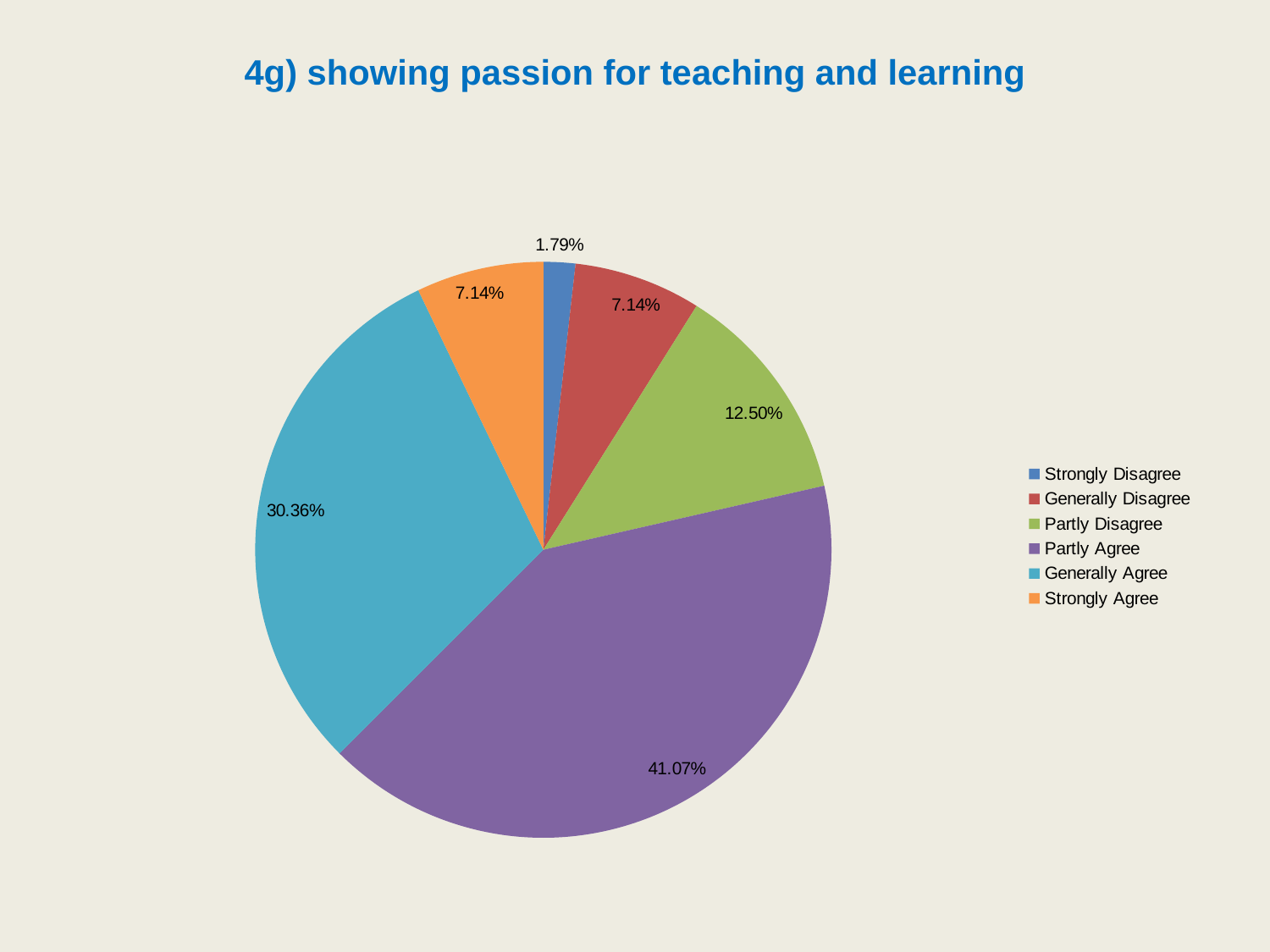
Which category has the smallest slice of the pie? Strongly Disagree What share of the pie is Strongly Disagree? 1.79% What is the difference between the Partly Agree and Generally Agree shares? 10.71% What is the title of the chart? 4g) showing passion for teaching and learning What kind of chart is shown on the slide? pie chart Which category has the largest slice of the pie? Partly Agree Which is larger, the Partly Disagree slice or the Generally Disagree slice? Partly Disagree What share of the pie is Generally Agree? 30.36% What colour is the Generally Agree slice? teal blue How many categories does the legend list? 6 What share of the pie is Partly Disagree? 12.50%